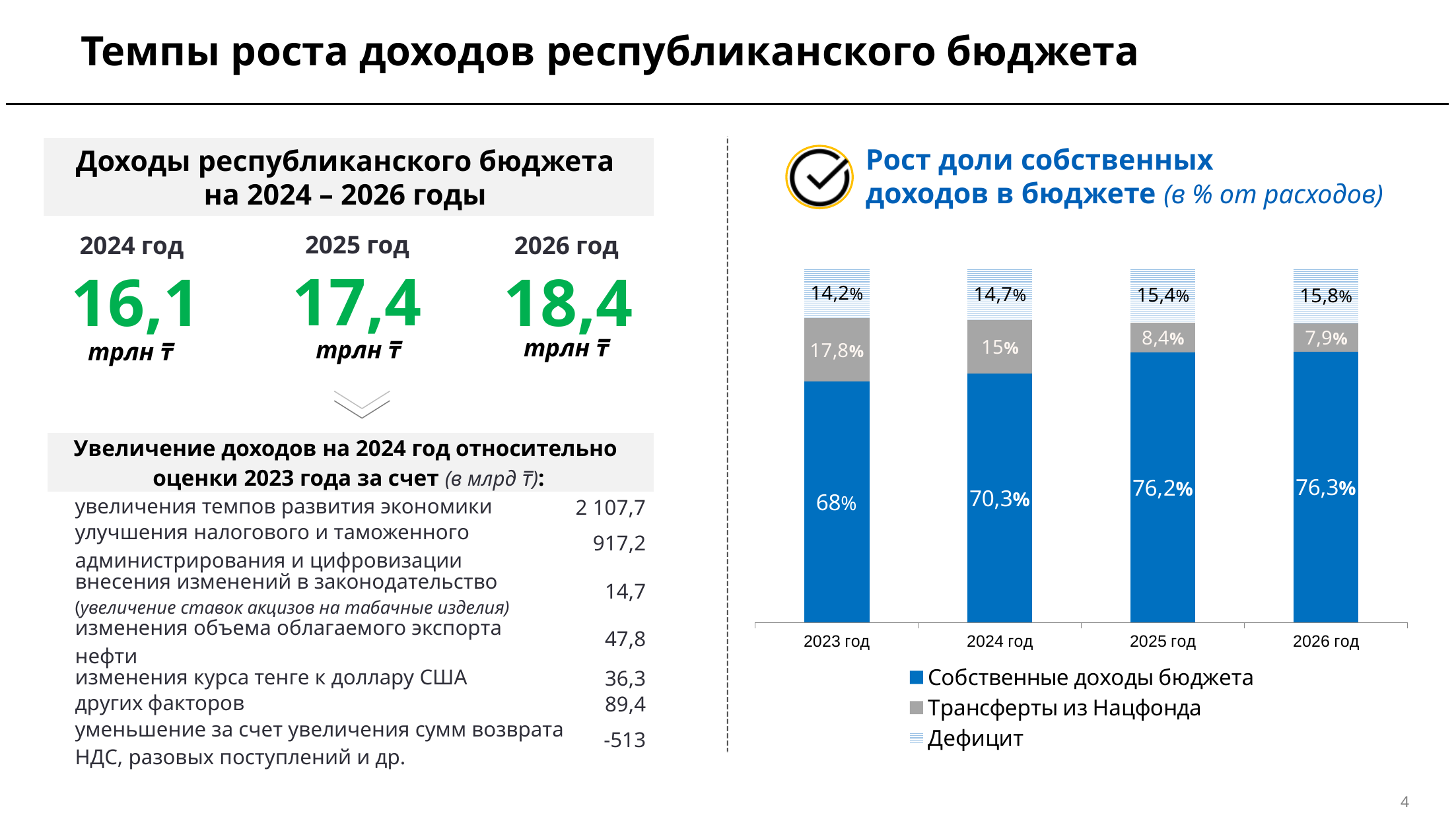
What is the total of the stacked bar for 2024 год? 100% What kind of chart is shown on the slide? Stacked bar chart What is the value of Дефицит for 2026 год? 15,8% What is the value of Собственные доходы бюджета for 2023 год? 68% Does the share of Собственные доходы бюджета rise or fall from 2023 год to 2026 год? Rise In which year is the share of Трансферты из Нацфонда the highest? 2023 год What is the difference between the Трансферты из Нацфонда share in 2023 год and in 2026 год? 9,9% How many series does the chart legend list? 3 What is the value of Трансферты из Нацфонда for 2025 год? 8,4% For 2023 год, which is larger: Трансферты из Нацфонда or Дефицит? Трансферты из Нацфонда How many years are shown on the x axis of the chart? 4 In which year is the share of Собственные доходы бюджета the lowest? 2023 год